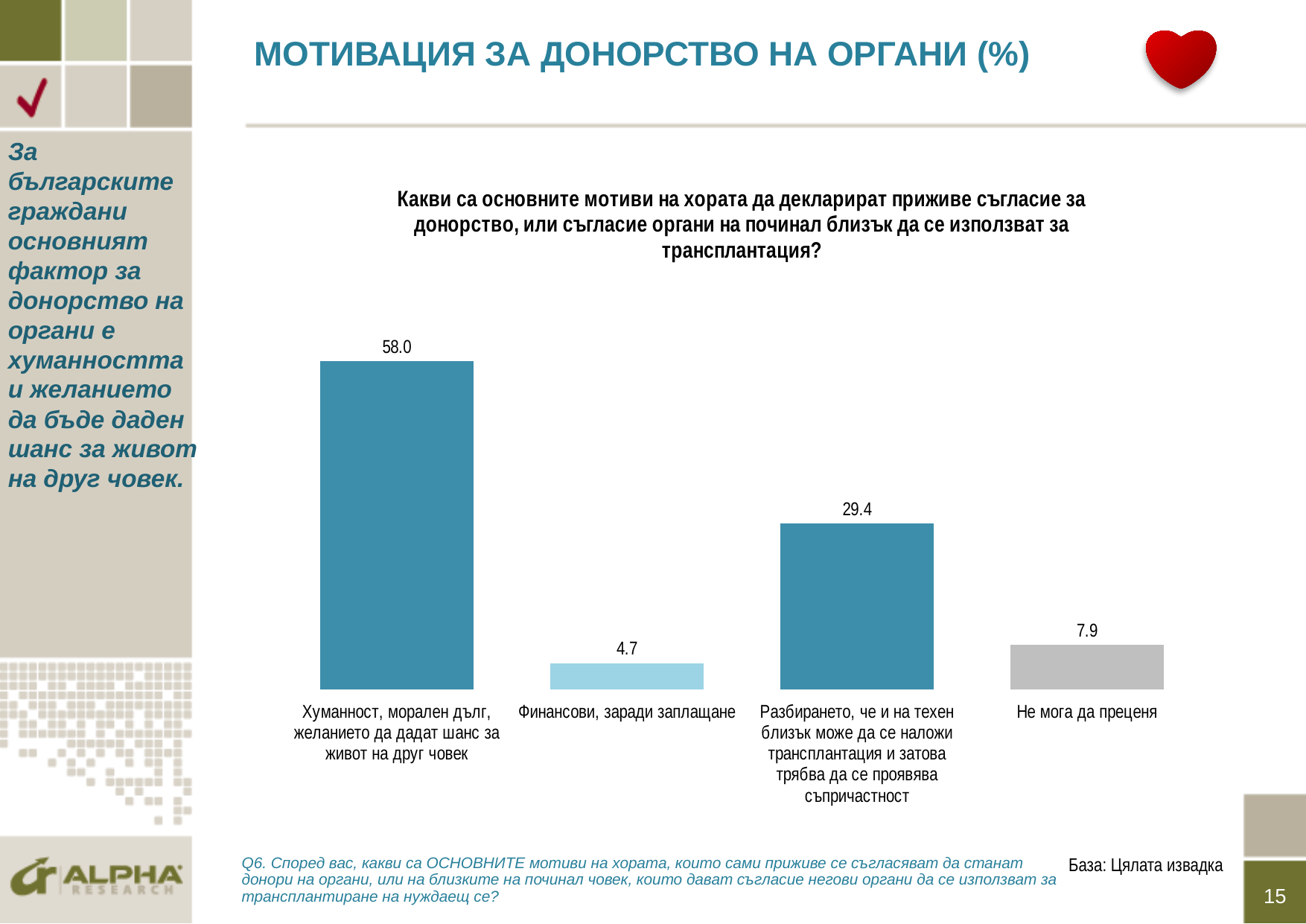
Which is larger: the value for "Не мога да преценя" or the value for "Финансови, заради заплащане"? Не мога да преценя What kind of chart is shown on the slide? Bar chart How many categories are shown in the chart? 4 What is the value for "Разбирането, че и на техен близък може да се наложи трансплантация и затова трябва да се проявява съпричастност"? 29.4 What is the value for "Финансови, заради заплащане"? 4.7 What is the title of the slide? МОТИВАЦИЯ ЗА ДОНОРСТВО НА ОРГАНИ (%) Which category has the highest value? Хуманност, морален дълг, желанието да дадат шанс за живот на друг човек What is the difference between the values for "Хуманност, морален дълг, желанието да дадат шанс за живот на друг човек" and "Разбирането, че и на техен близък може да се наложи трансплантация и затова трябва да се проявява съпричастност"? 28.6 What is the difference between the values for "Не мога да преценя" and "Финансови, заради заплащане"? 3.2 What is the value for "Не мога да преценя"? 7.9 What is the value for "Хуманност, морален дълг, желанието да дадат шанс за живот на друг човек"? 58.0 Which category has the lowest value? Финансови, заради заплащане